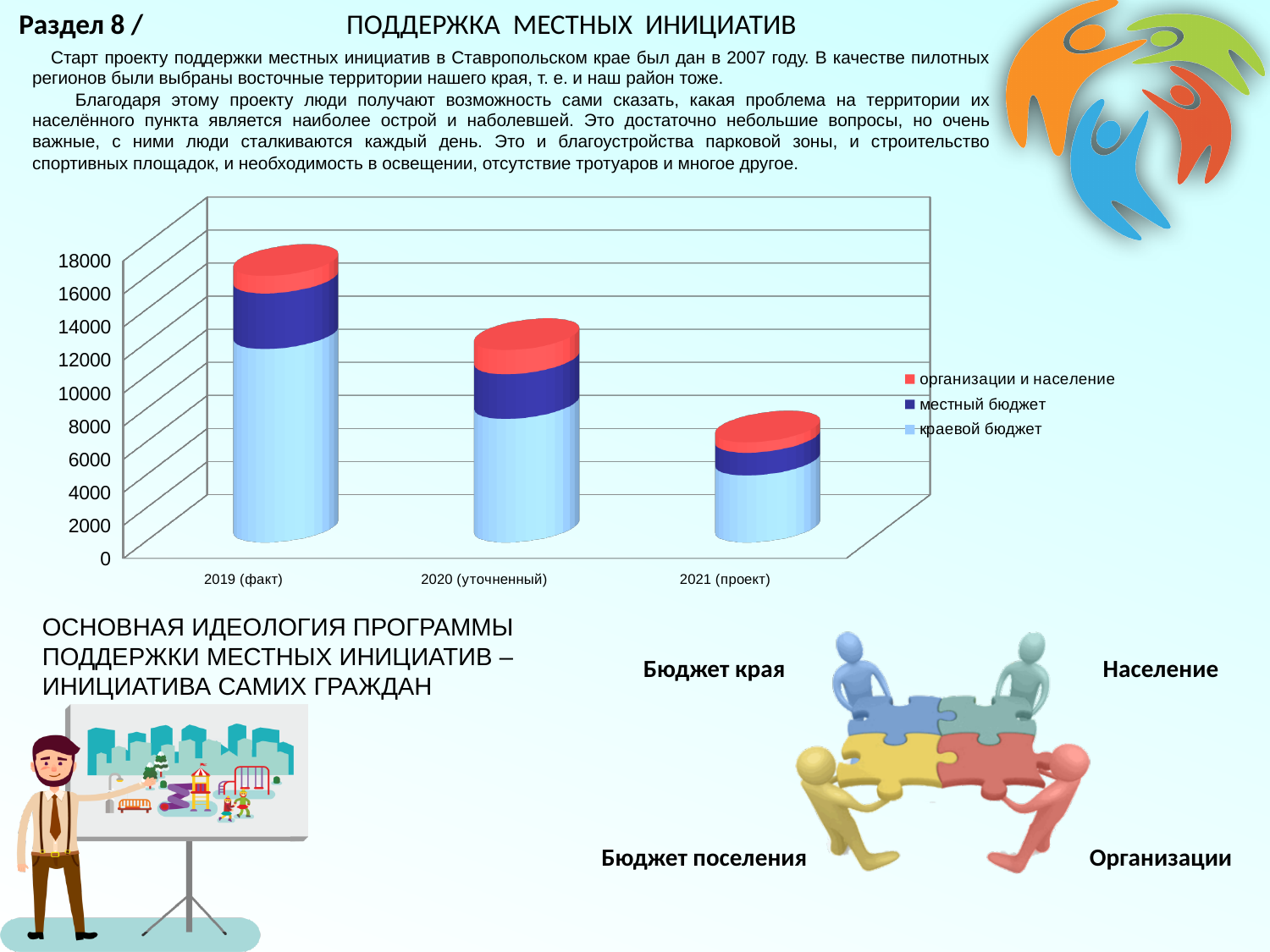
Which series is shown in red in the chart legend? организации и население How many categories are shown on the x axis of the chart? 3 What kind of chart is shown on the slide? stacked bar chart Which is larger: the stacked bar total for 2020 (уточненный) or for 2021 (проект)? 2020 (уточненный) Is the total of the stacked bar for 2020 (уточненный) greater or less than 10000? greater Is the total of the stacked bar for 2021 (проект) greater or less than 10000? less Which category has the shortest stacked bar in the chart? 2021 (проект) Which category has the tallest stacked bar in the chart? 2019 (факт) How many series does the chart legend list? 3 Is the краевой бюджет value for 2019 (факт) greater or less than 10000? greater Do the stacked bar totals rise or fall from 2019 (факт) to 2021 (проект)? fall